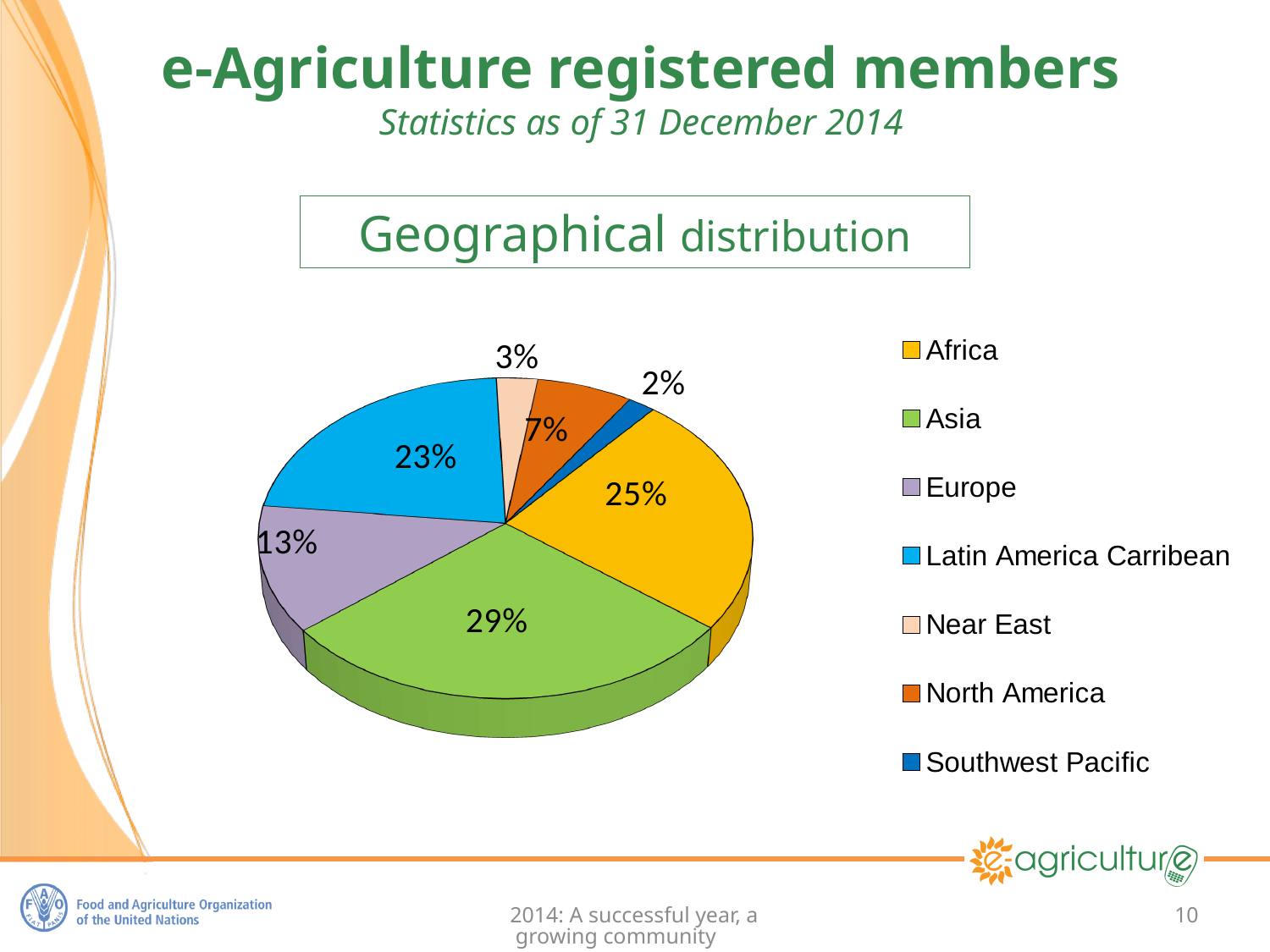
What share of registered members is from Asia? 29% What share of registered members is from Latin America Carribean? 23% Which region has the smallest share of registered members? Southwest Pacific What type of chart is used to show the geographical distribution? Pie chart What share of registered members is from Southwest Pacific? 2% Which colour represents Europe in the pie chart? Purple What share of registered members is from Africa? 25% What share of registered members is from Europe? 13% Which has a larger share, North America or Near East? North America What is the difference in percentage points between the Asia and Africa shares? 4 Which region has the largest share of registered members? Asia How many regions are shown in the pie chart? 7